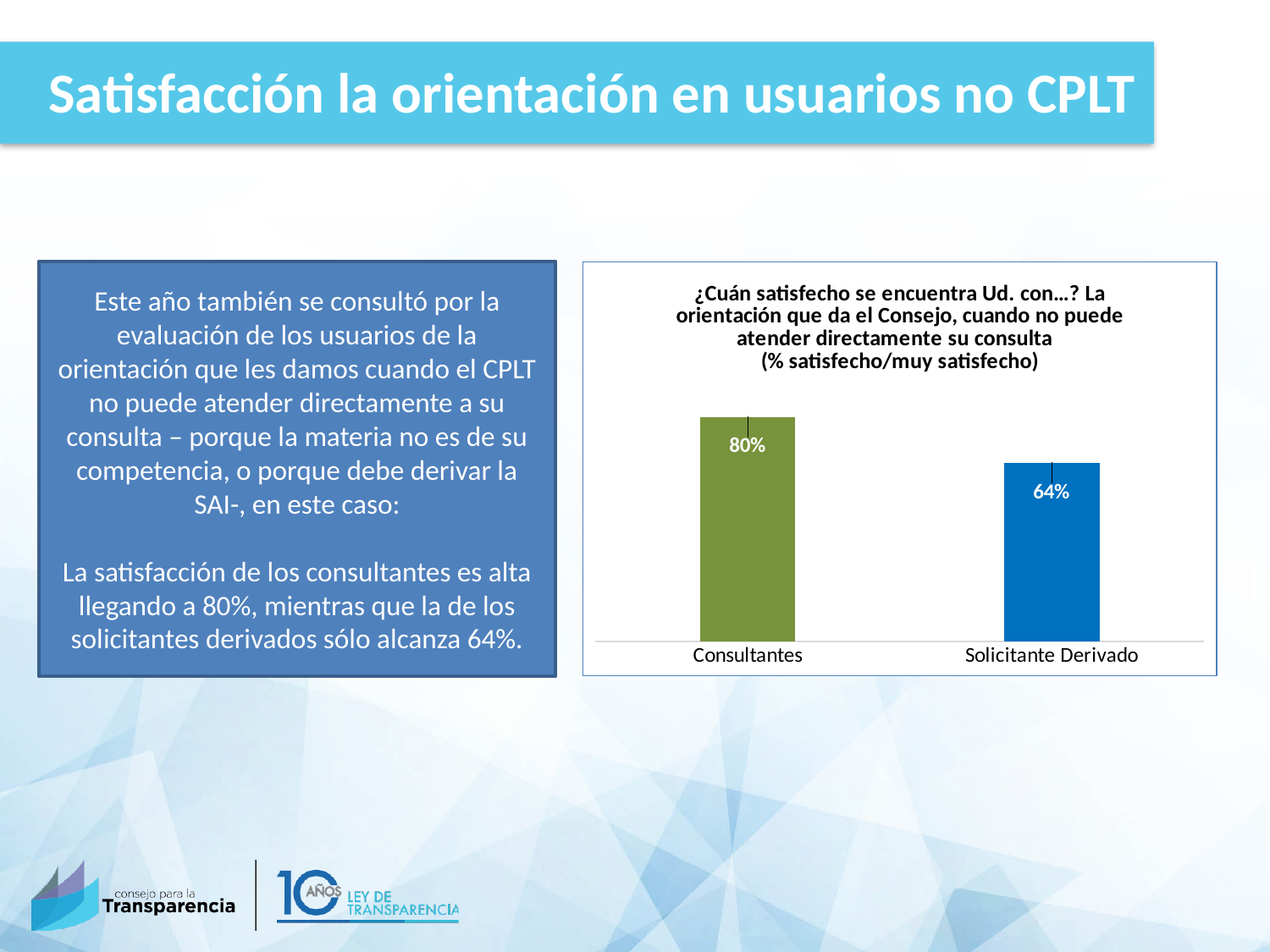
What is the value for Solicitante Derivado? 64% What kind of chart is shown on the slide? Bar chart Which category has the highest value? Consultantes What colour is the bar for Solicitante Derivado? Blue What is the value for Consultantes? 80% How many categories are shown in the chart? 2 Do the values rise or fall from Consultantes to Solicitante Derivado? Fall What colour is the bar for Consultantes? Green Which category has the lowest value? Solicitante Derivado Which is larger, the value for Consultantes or for Solicitante Derivado? Consultantes What is the difference between the values for Consultantes and Solicitante Derivado? 16%